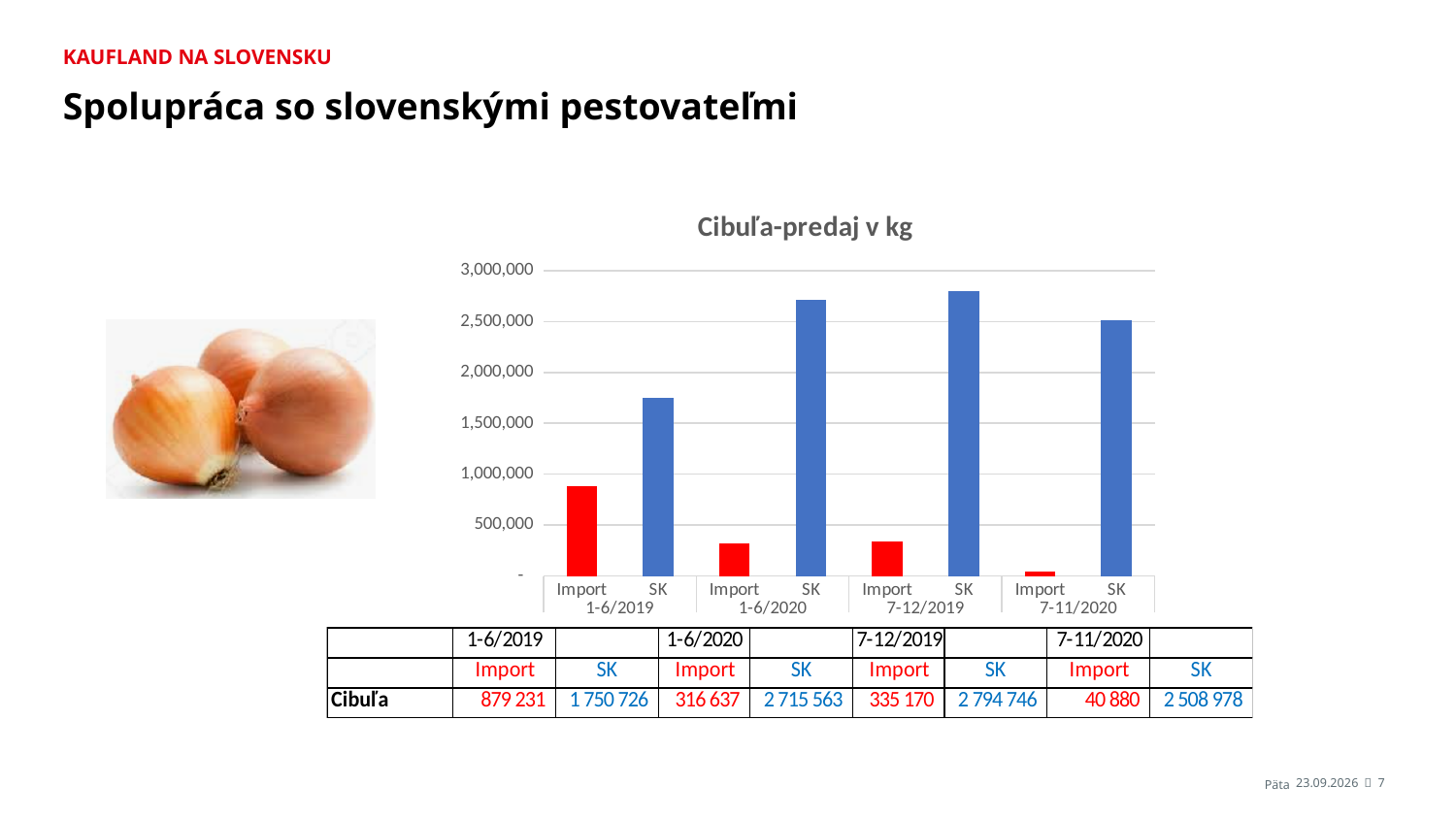
Is the value for Import 1-6/2019 greater or less than 1,000,000? less What kind of chart is shown on the slide? bar chart What is the value for SK in the period 7-12/2019? 2 794 746 Which bar has the highest value in the chart? SK 7-12/2019 Which is larger, the Import value for 1-6/2019 or the Import value for 1-6/2020? Import 1-6/2019 Which bar has the lowest value in the chart? Import 7-11/2020 What colour are the Import bars in the chart? red What is the value for Import in the period 7-11/2020? 40 880 What is the title of the chart? Cibuľa-predaj v kg How many bars are plotted in the chart? 8 What is the value for SK in the period 1-6/2019? 1 750 726 What is the difference between the SK and Import values for the period 1-6/2019? 871 495